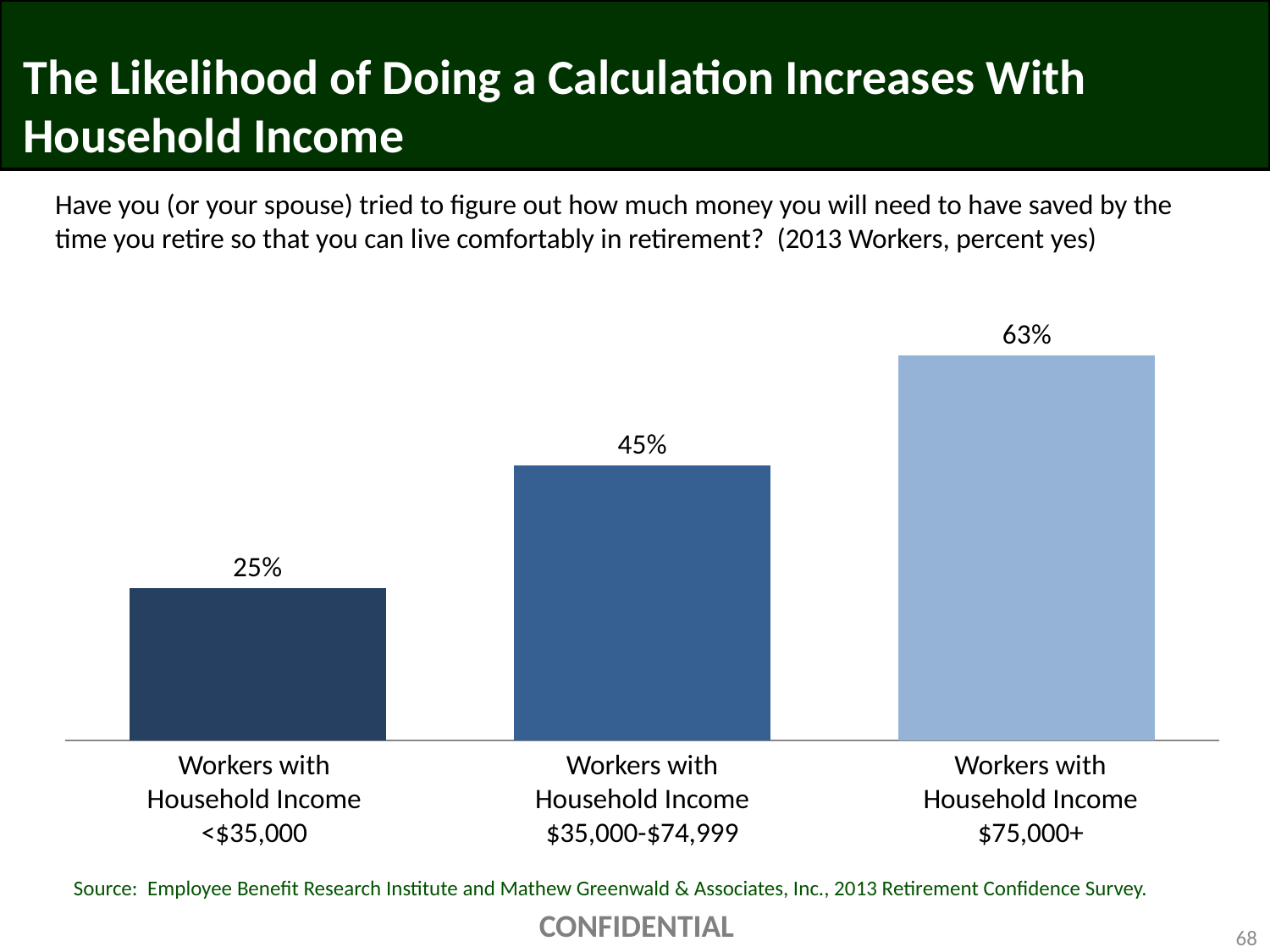
What is the title of the slide? The Likelihood of Doing a Calculation Increases With Household Income Which household income group has the highest percentage saying yes? Workers with Household Income $75,000+ Which household income group has the lowest percentage saying yes? Workers with Household Income <$35,000 Do the values rise or fall as household income increases from left to right? Rise What is the difference in percentage points between the $75,000+ group and the <$35,000 group? 38 Which group has a higher percentage saying yes: $35,000-$74,999 or $75,000+? $75,000+ How many household income groups are shown in the chart? 3 What is the difference in percentage points between the $35,000-$74,999 group and the <$35,000 group? 20 What percentage of workers with household income $35,000-$74,999 said yes? 45% What kind of chart is shown on the slide? Bar chart What percentage of workers with household income <$35,000 said yes? 25% What percentage of workers with household income $75,000+ said yes? 63%